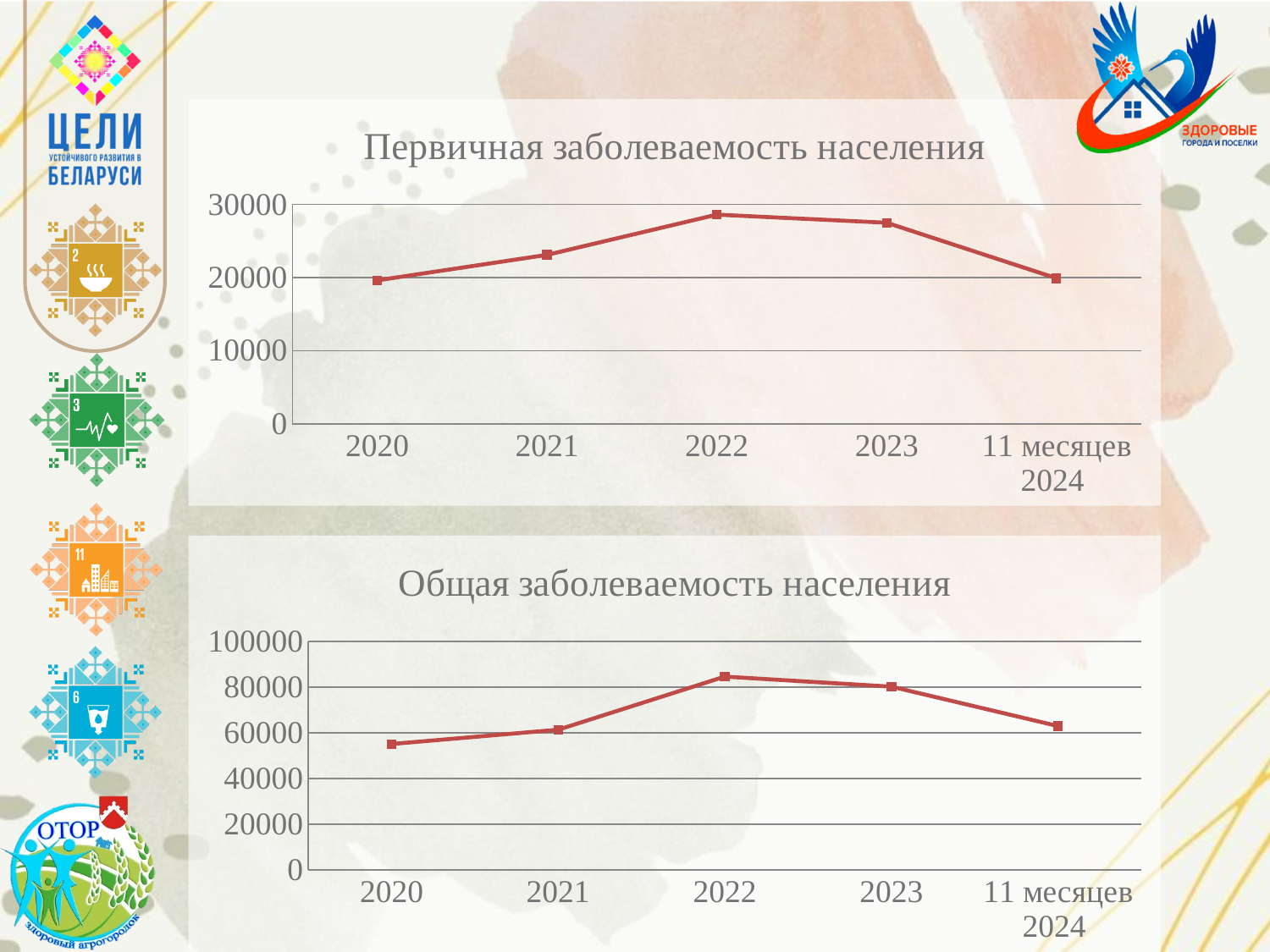
In the bottom chart "Общая заболеваемость населения", do the values rise or fall from 2020 to 2022? rise What kind of chart is the bottom chart titled "Общая заболеваемость населения"? line chart In the bottom chart "Общая заболеваемость населения", is the value for 2020 greater or less than 60000? less In the top chart "Первичная заболеваемость населения", how many points are plotted along the x axis? 5 In the bottom chart "Общая заболеваемость населения", which year has the highest value? 2022 What kind of chart is the top chart titled "Первичная заболеваемость населения"? line chart In the top chart "Первичная заболеваемость населения", is the value for 2022 greater or less than 20000? greater In the bottom chart "Общая заболеваемость населения", is the value for 2022 greater or less than 80000? greater In the bottom chart "Общая заболеваемость населения", which category has the lowest value? 2020 In the top chart "Первичная заболеваемость населения", which year has the highest value? 2022 In the top chart "Первичная заболеваемость населения", which is larger: the value for 2021 or the value for 2023? 2023 In the bottom chart "Общая заболеваемость населения", how many categories are shown on the x axis? 5